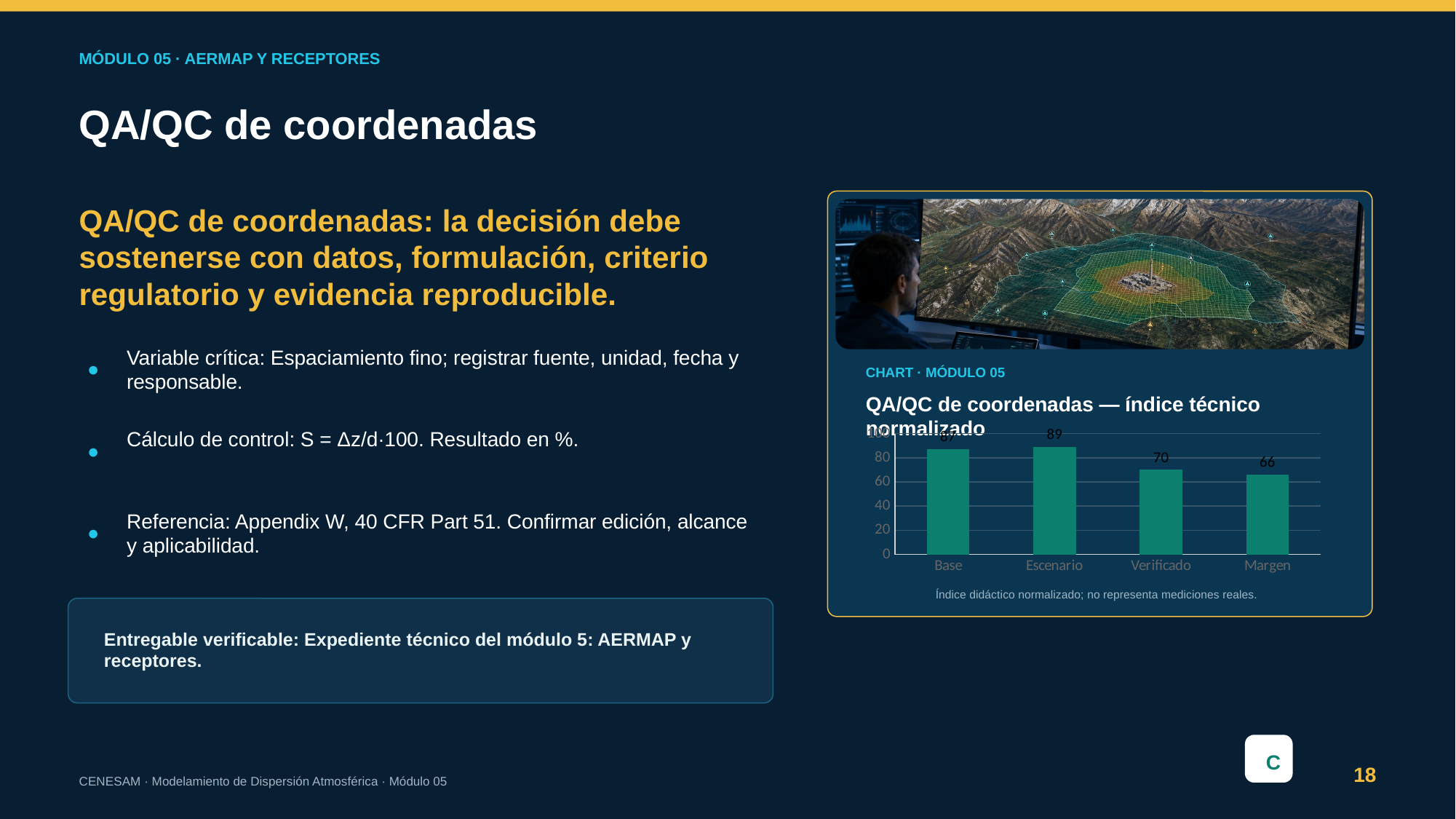
What is the value for Margen in the chart? 66 Is the value for Margen greater or less than 80? less How many categories are shown in the chart? 4 What is the difference between the values for Escenario and Verificado? 19 What is the value for Escenario in the chart? 89 What is the value for Verificado in the chart? 70 Which category has the highest value in the chart? Escenario What type of chart is shown on the slide? Bar chart What is the difference between the values for Verificado and Margen? 4 Which category has the lowest value in the chart? Margen Which is larger, the value for Verificado or the value for Margen? Verificado What is the value for Base in the chart? 87